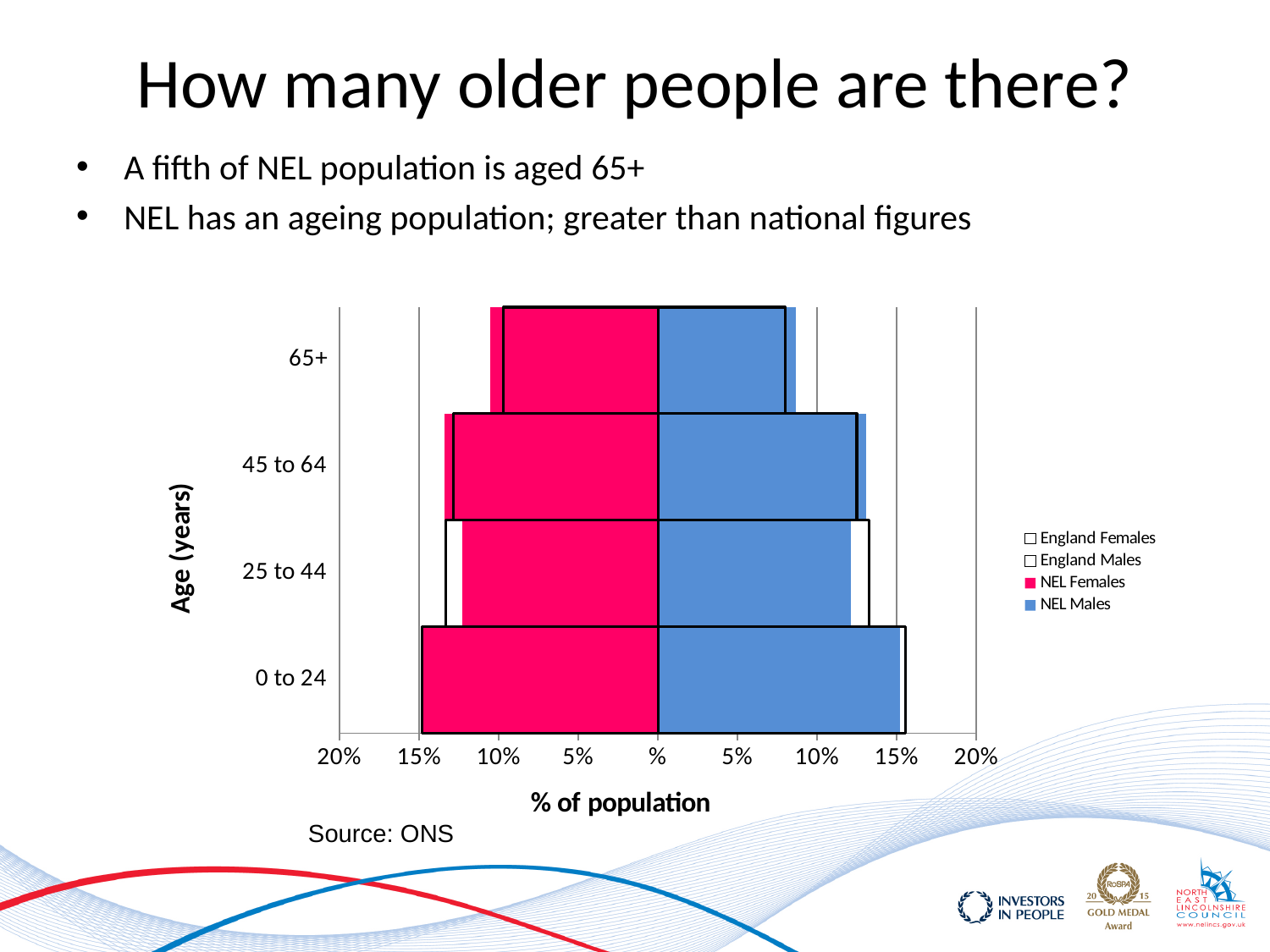
For the 65+ age group, which is larger: NEL Females or England Females? NEL Females Is the value for NEL Females aged 45 to 64 greater or less than 10%? greater Is the value for NEL Males aged 0 to 24 greater or less than 10%? greater How many series does the chart legend list? 4 What kind of chart is shown on the slide? bar chart Is the value for NEL Males aged 65+ greater or less than 10%? less Which age group has the lowest value for NEL Males? 65+ Which age group has the highest value for NEL Males? 0 to 24 For the 25 to 44 age group, which is larger: NEL Males or England Males? England Males What is the title of the chart's horizontal axis? % of population How many age groups are shown on the chart? 4 Which age group has the lowest value for NEL Females? 65+